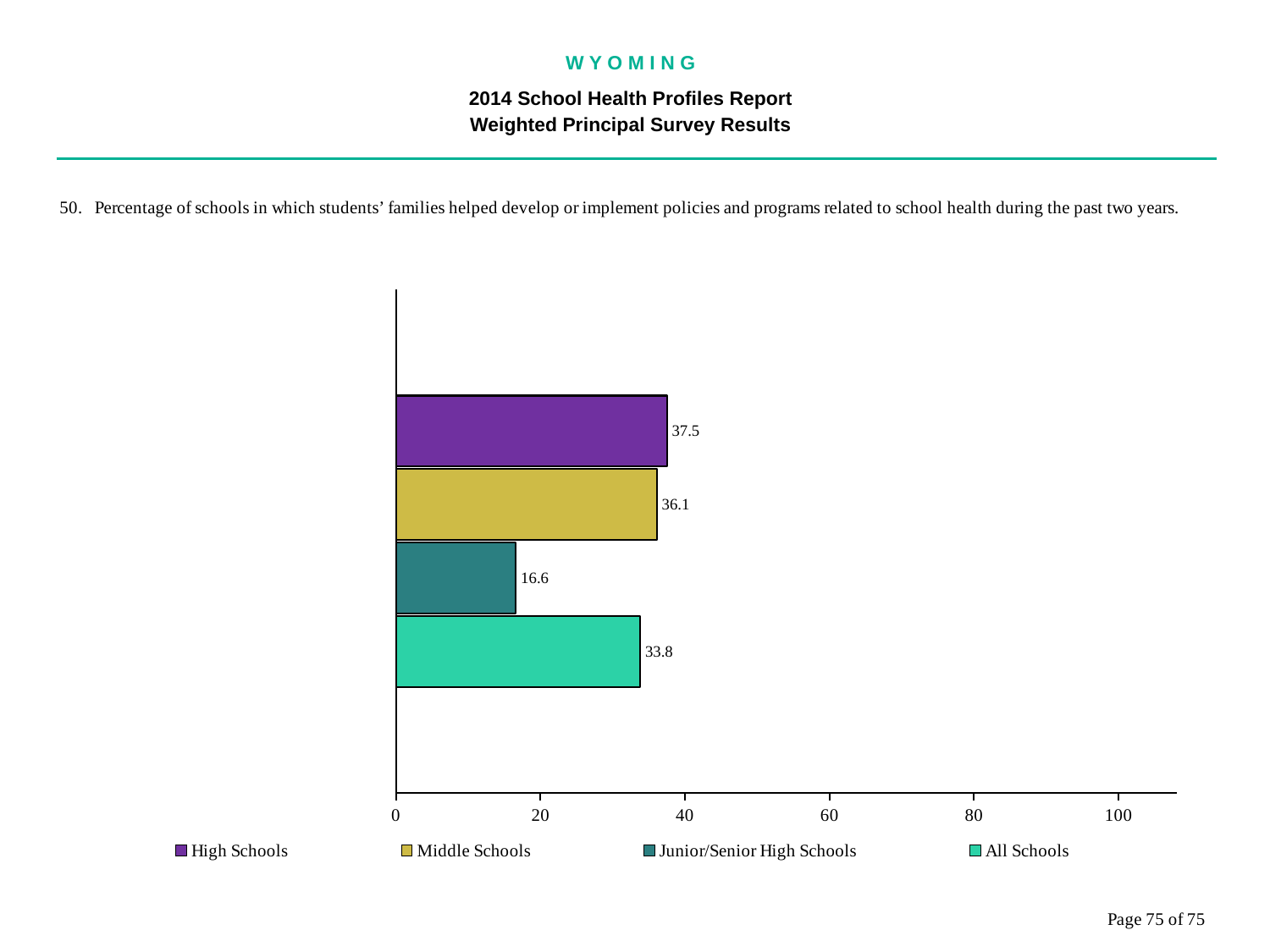
Which school type has the lowest value? Junior/Senior High Schools Which school type has the highest value? High Schools What is the value for All Schools? 33.8 What is the value for High Schools? 37.5 Which is larger, the value for Middle Schools or the value for Junior/Senior High Schools? Middle Schools Is the value for All Schools greater or less than 40? less What kind of chart is shown on the slide? bar chart What is the value for Middle Schools? 36.1 What is the value for Junior/Senior High Schools? 16.6 How many series does the legend list? 4 What is the difference between the values for High Schools and Junior/Senior High Schools? 20.9 What is the difference between the values for Middle Schools and All Schools? 2.3